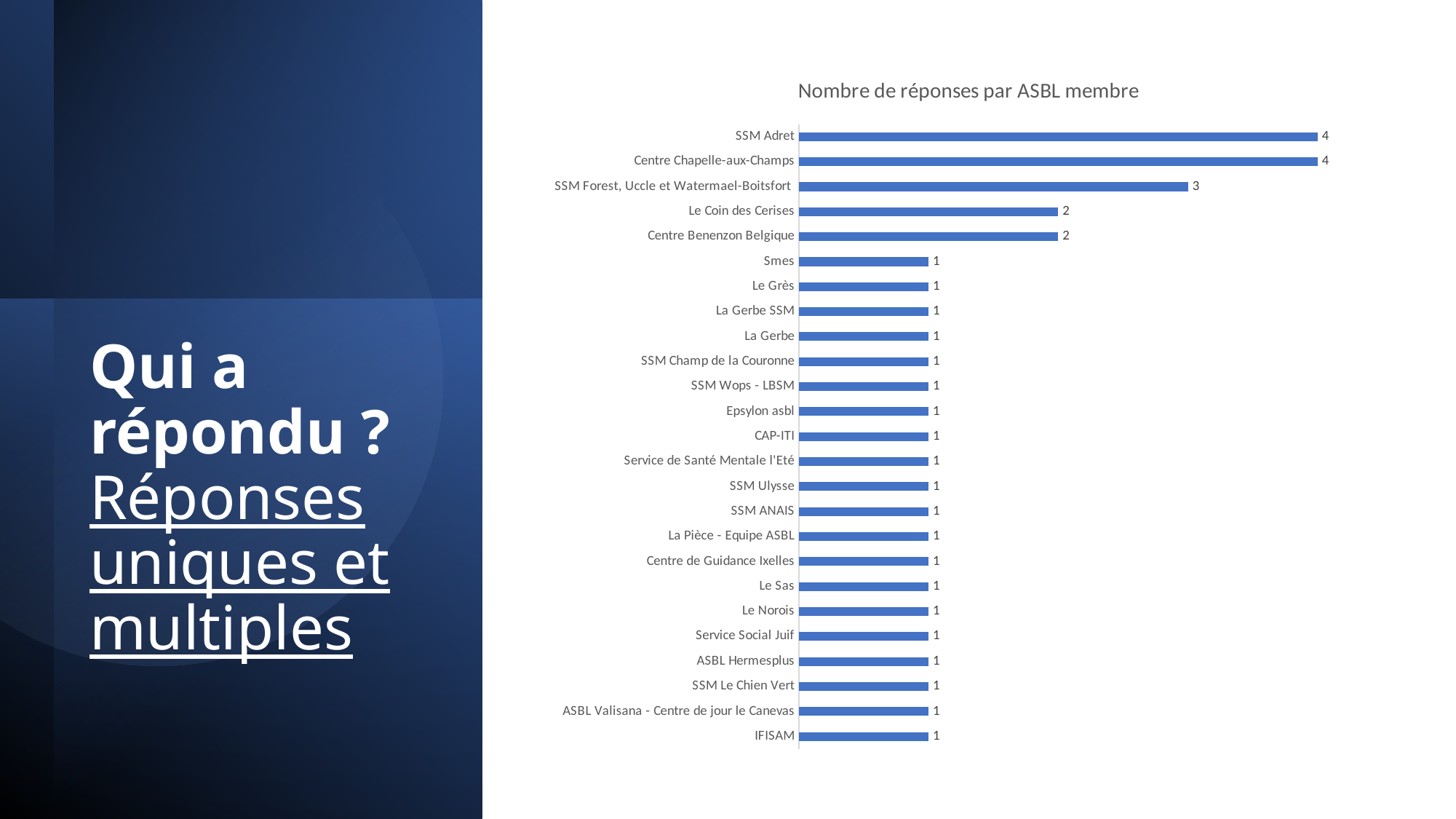
Which has a larger value, SSM Forest, Uccle et Watermael-Boitsfort or Le Coin des Cerises? SSM Forest, Uccle et Watermael-Boitsfort What is the value for IFISAM? 1 How many ASBL members have a value of 1? 20 How many ASBL members (categories) are listed in the chart? 25 What is the difference between the values for Centre Chapelle-aux-Champs and Centre Benenzon Belgique? 2 What is the lowest value shown in the chart? 1 What is the title of the chart? Nombre de réponses par ASBL membre What kind of chart is shown on the slide? Bar chart What is the highest value shown in the chart? 4 What is the value for Le Coin des Cerises? 2 What is the value for SSM Adret? 4 What is the value for SSM Forest, Uccle et Watermael-Boitsfort? 3